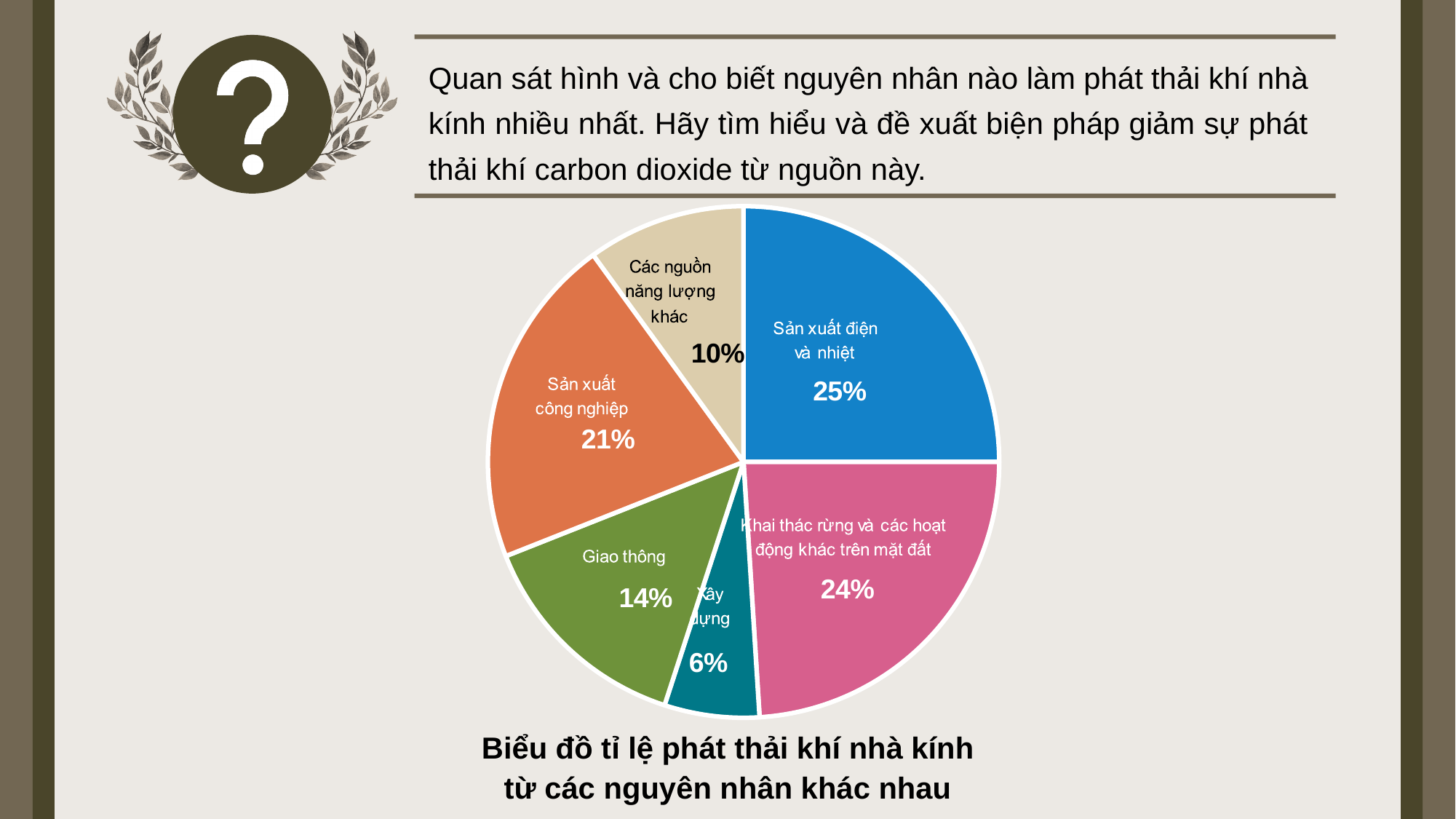
What percentage is shown for Xây dựng? 6% How many slices does the pie chart have? 6 Which category has the largest share of the pie? Sản xuất điện và nhiệt Which category has the smallest share of the pie? Xây dựng What is the value for Sản xuất công nghiệp? 21% What is the title of the chart? Biểu đồ tỉ lệ phát thải khí nhà kính từ các nguyên nhân khác nhau What percentage of greenhouse gas emissions comes from Sản xuất điện và nhiệt? 25% What is the share for Giao thông? 14% What is the difference between the shares of Sản xuất công nghiệp and Các nguồn năng lượng khác? 11% Which is larger, the share for Giao thông or the share for Các nguồn năng lượng khác? Giao thông What kind of chart is shown on the slide? Pie chart What share is labelled for Khai thác rừng và các hoạt động khác trên mặt đất? 24%